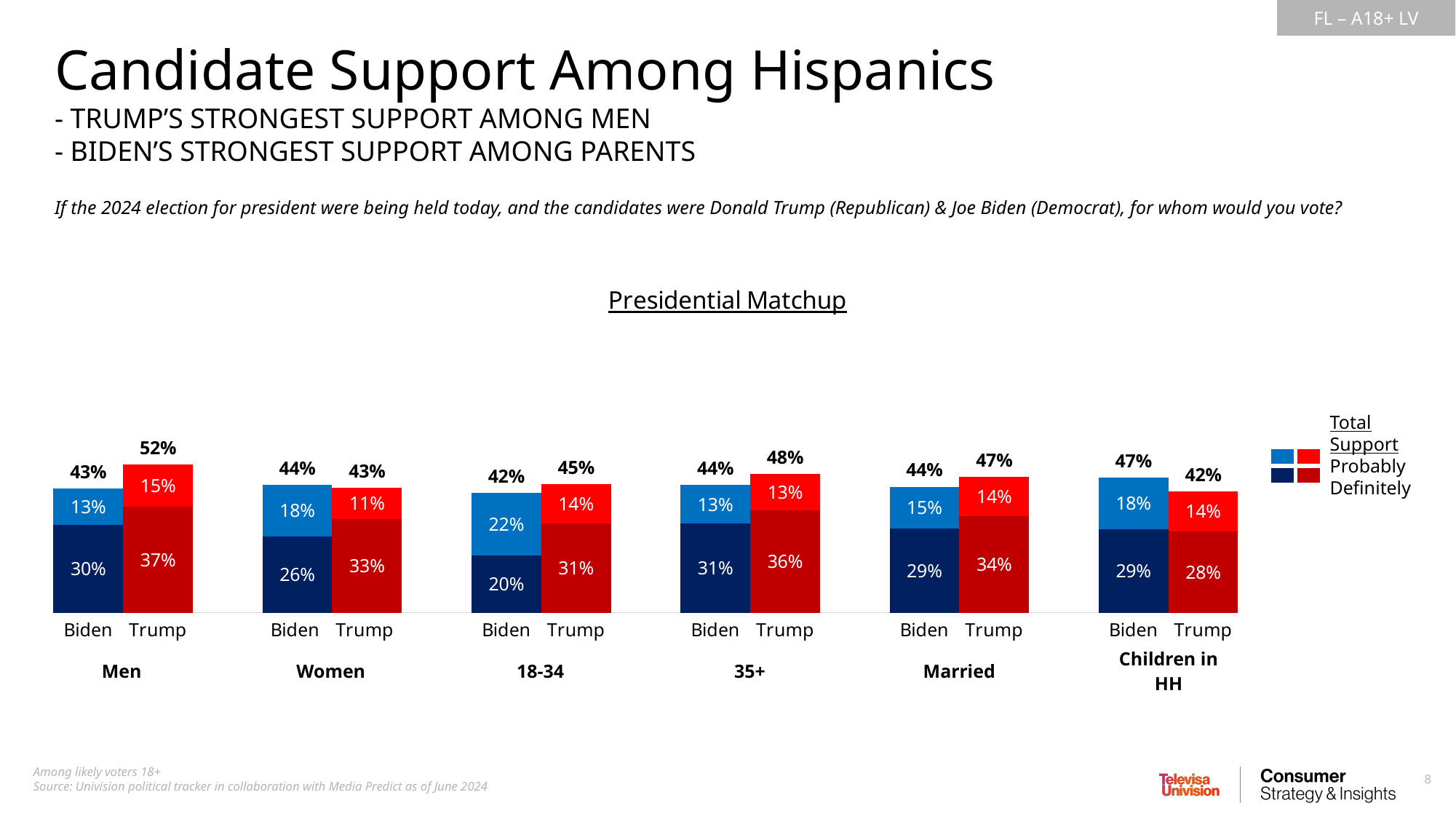
What is the difference between Trump's and Biden's total support among Men? 9 percentage points What kind of chart is shown under 'Presidential Matchup'? Stacked bar chart What share of Women say they would definitely vote for Biden? 26% How many support levels does the legend list? 2 (Probably and Definitely) What is the 'Probably' value for Biden among 18-34 year olds? 22% Among Married respondents, who has higher total support, Biden or Trump? Trump What is Trump's total support among Men? 52% What is Biden's total support among respondents with Children in HH? 47% What is the total of the stacked bar for Trump among 18-34 year olds (Definitely plus Probably)? 45% In which group is Biden's 'Definitely' support highest? 35+ (31%) How many demographic groups are shown on the chart? 6 Which candidate and group has the highest total support shown on the chart? Trump among Men (52%)